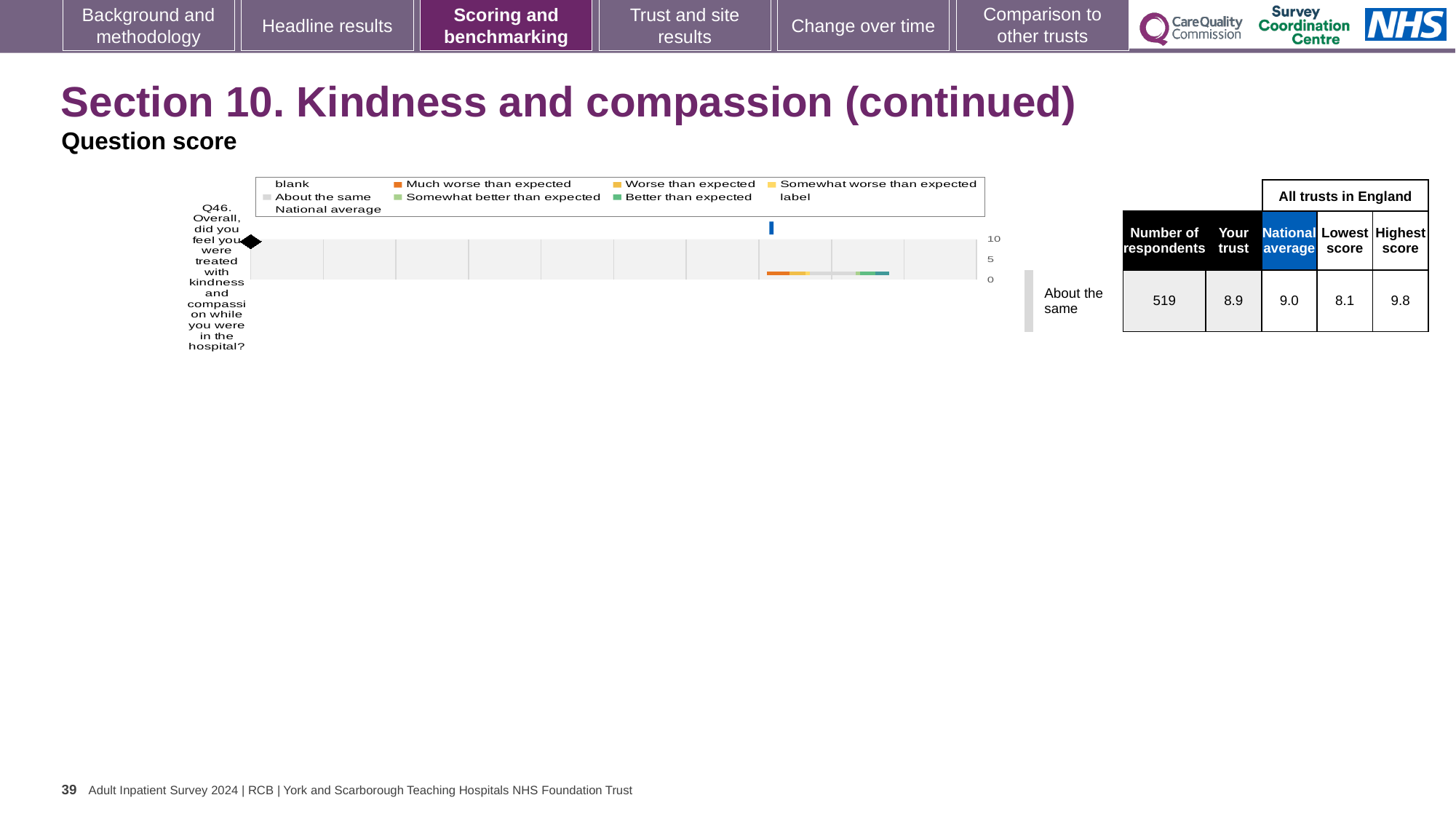
According to the table beside the chart, what is the score for Your trust on Q46? 8.9 Which question number is plotted on the chart? Q46 According to the table beside the chart, what is the Lowest score among all trusts in England for Q46? 8.1 According to the table beside the chart, how many respondents answered Q46? 519 What is the highest value shown on the chart's numeric axis? 10 What is the difference between the Highest score and the Lowest score for Q46 in the table beside the chart? 1.7 According to the table beside the chart, what is the National average score for Q46? 9.0 What benchmarking category is the trust's Q46 score placed in, as labelled next to the chart? About the same According to the table beside the chart, what is the Highest score among all trusts in England for Q46? 9.8 Which is larger for Q46, the Your trust score or the National average score? National average What kind of chart is shown on the slide? bar chart